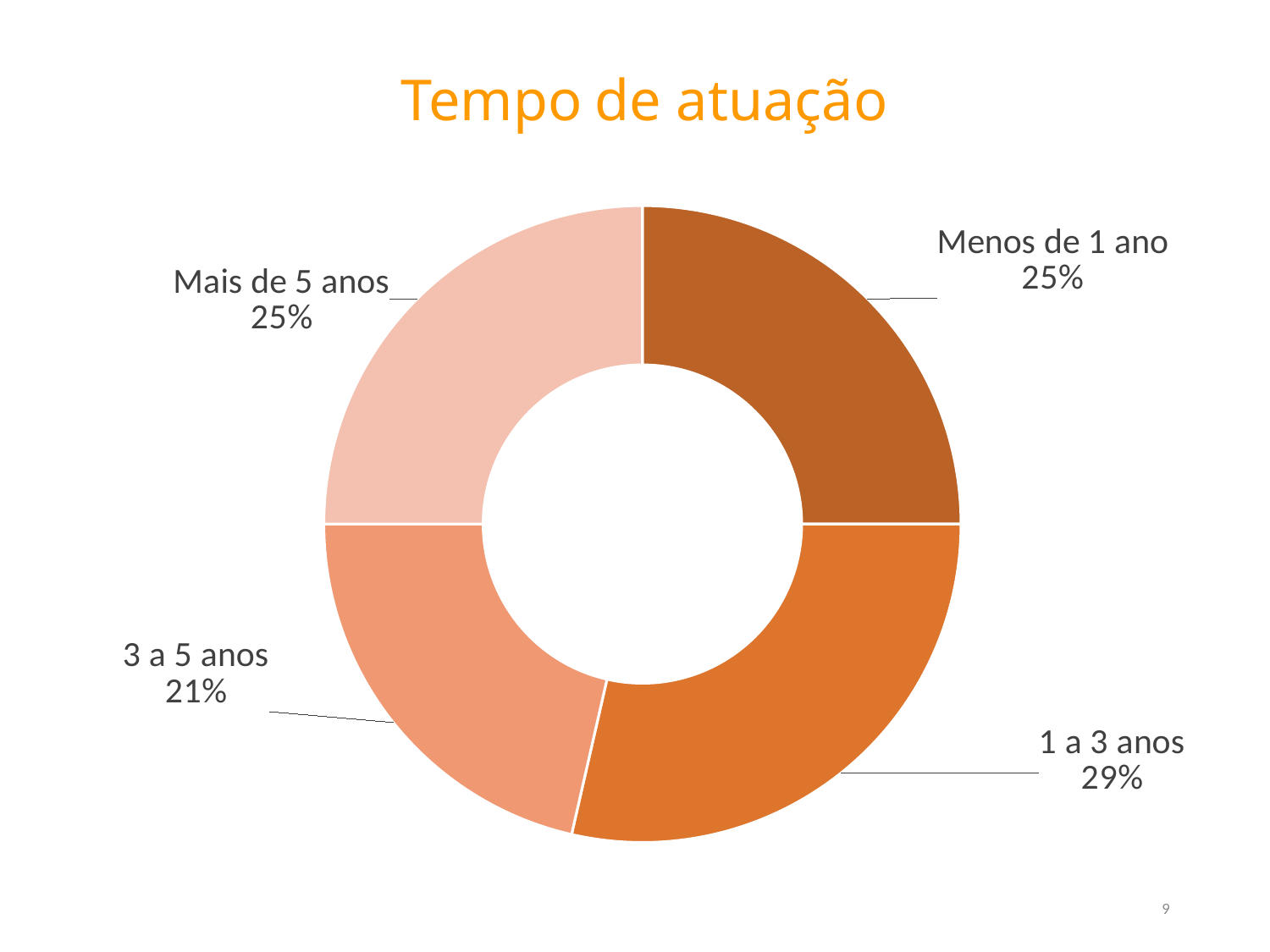
Which category has the largest share? 1 a 3 anos Which is larger, the share for "1 a 3 anos" or the share for "Menos de 1 ano"? 1 a 3 anos What kind of chart is shown on the slide? Doughnut chart Which slice is shown in the darkest shade of orange? Menos de 1 ano What share does the "Menos de 1 ano" slice represent? 25% How many categories are shown in the chart? 4 What share does the "1 a 3 anos" slice represent? 29% What share does the "Mais de 5 anos" slice represent? 25% What is the difference in percentage points between "1 a 3 anos" and "3 a 5 anos"? 8 percentage points What is the title of the chart? Tempo de atuação What share does the "3 a 5 anos" slice represent? 21% Which category has the smallest share? 3 a 5 anos